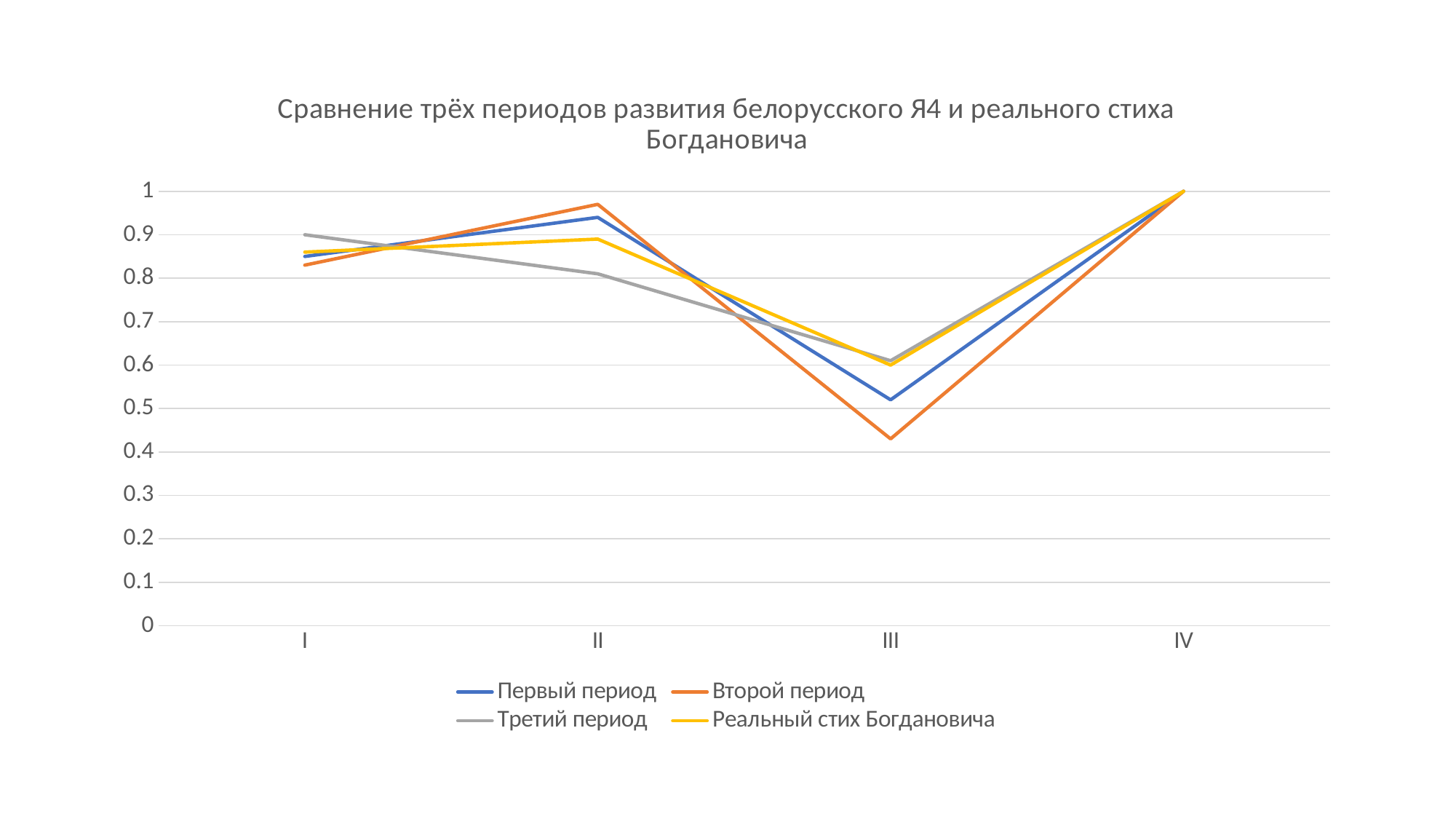
Is the value for Третий период at category II greater or less than 0.9? less At which category does Второй период reach its lowest value? III What colour is the line for Реальный стих Богдановича? yellow At category III, which is larger: Первый период or Второй период? Первый период At which category does Второй период reach its highest value? IV What kind of chart is shown on the slide? line chart Is the value for Второй период at category III greater or less than 0.5? less What is the value of Первый период at category IV? 1 At category II, which is larger: Второй период or Третий период? Второй период Does the Третий период line rise or fall from category I to category III? fall How many series does the legend list? 4 How many categories are shown on the x axis? 4